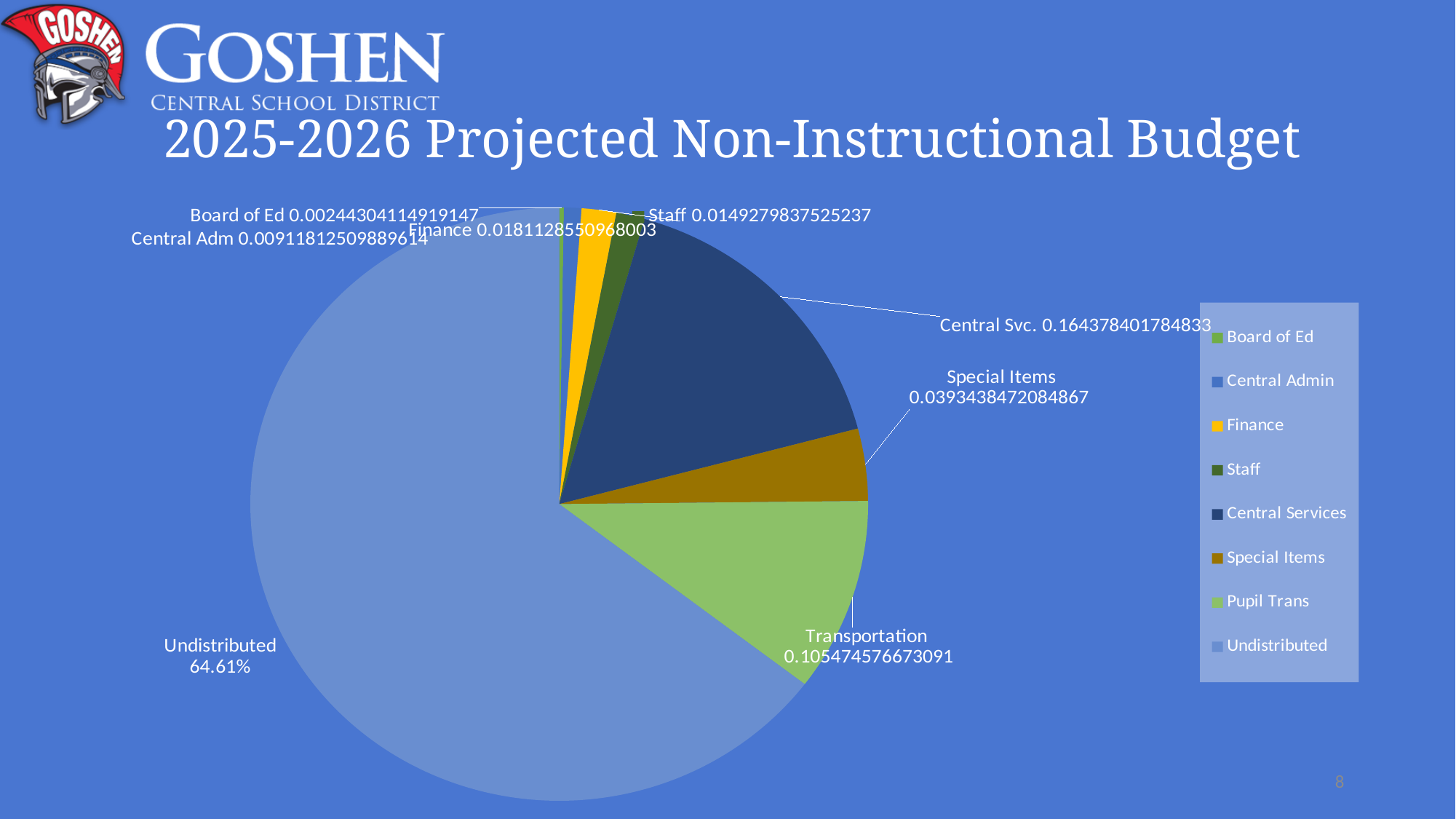
What value is shown for Special Items in the pie chart? 0.0393438472084867 What value is shown for Transportation in the pie chart? 0.105474576673091 How many categories does the legend list? 8 What share of the projected non-instructional budget is Undistributed? 64.61% What kind of chart is shown on the slide? pie chart Which is larger, the Finance value or the Staff value? Finance Which category has the largest slice of the pie chart? Undistributed What value is shown for Board of Ed in the pie chart? 0.00244304114919147 What value is shown for Central Svc. in the pie chart? 0.164378401784833 Which is larger, the Central Svc. slice or the Transportation slice? Central Svc. What value is shown for Staff in the pie chart? 0.0149279837525237 Which category has the smallest slice of the pie chart? Board of Ed